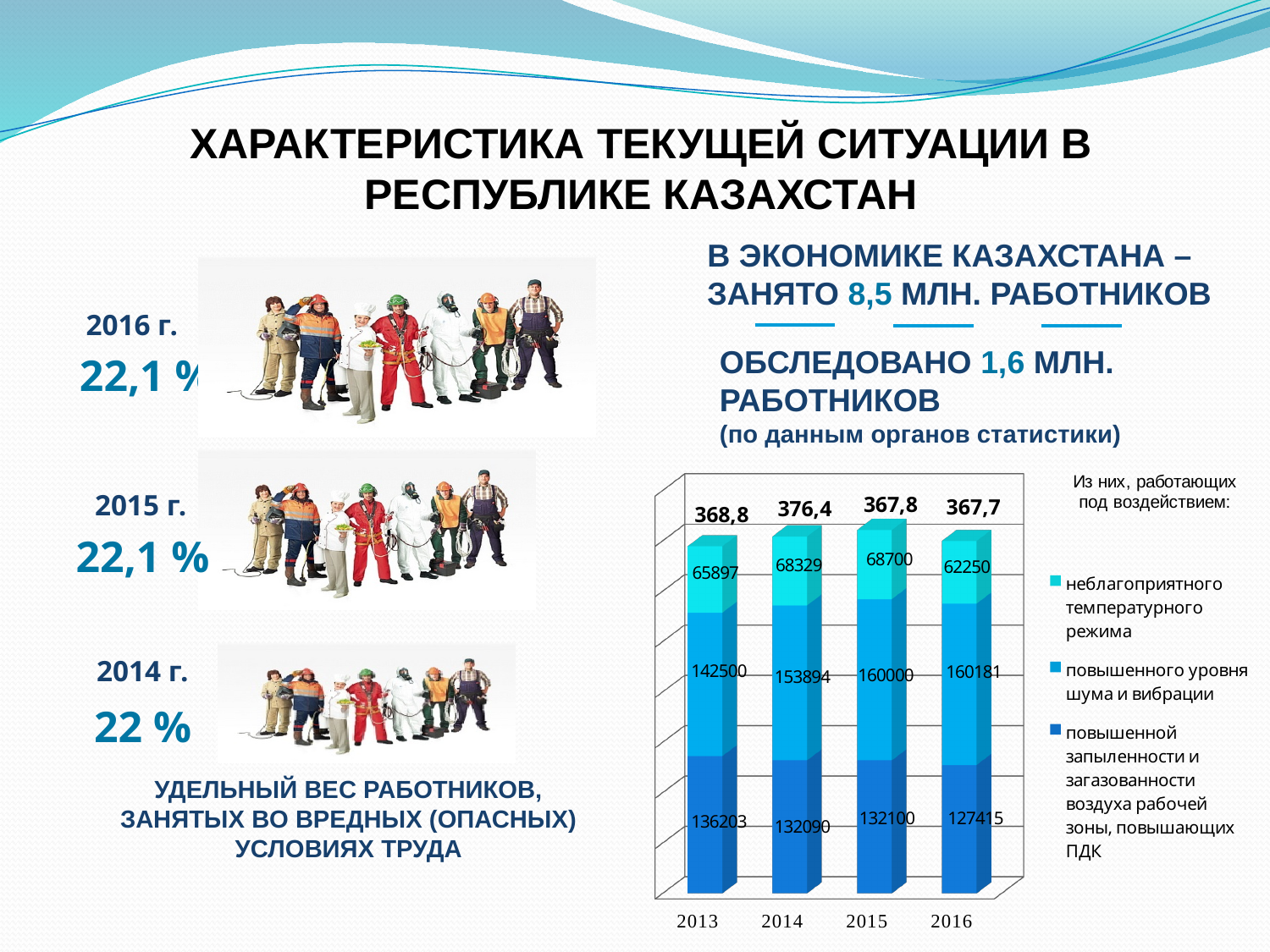
In which year is the value for неблагоприятного температурного режима the lowest? 2016 What is the value for повышенной запыленности и загазованности воздуха рабочей зоны in 2016? 127415 What is the value for повышенного уровня шума и вибрации in 2015? 160000 What is the difference between the 2014 and 2013 values for повышенного уровня шума и вибрации? 11394 In which year is the value for повышенного уровня шума и вибрации the highest? 2016 What is the value for неблагоприятного температурного режима in 2013? 65897 What kind of chart is shown on the slide? Stacked bar chart How many years are shown on the x axis of the chart? 4 How many series does the chart legend list? 3 What total is printed above the 2014 bar? 376,4 Which year has the larger value for повышенной запыленности и загазованности воздуха рабочей зоны, 2013 or 2014? 2013 Does the value for повышенного уровня шума и вибрации rise or fall from 2013 to 2016? Rises